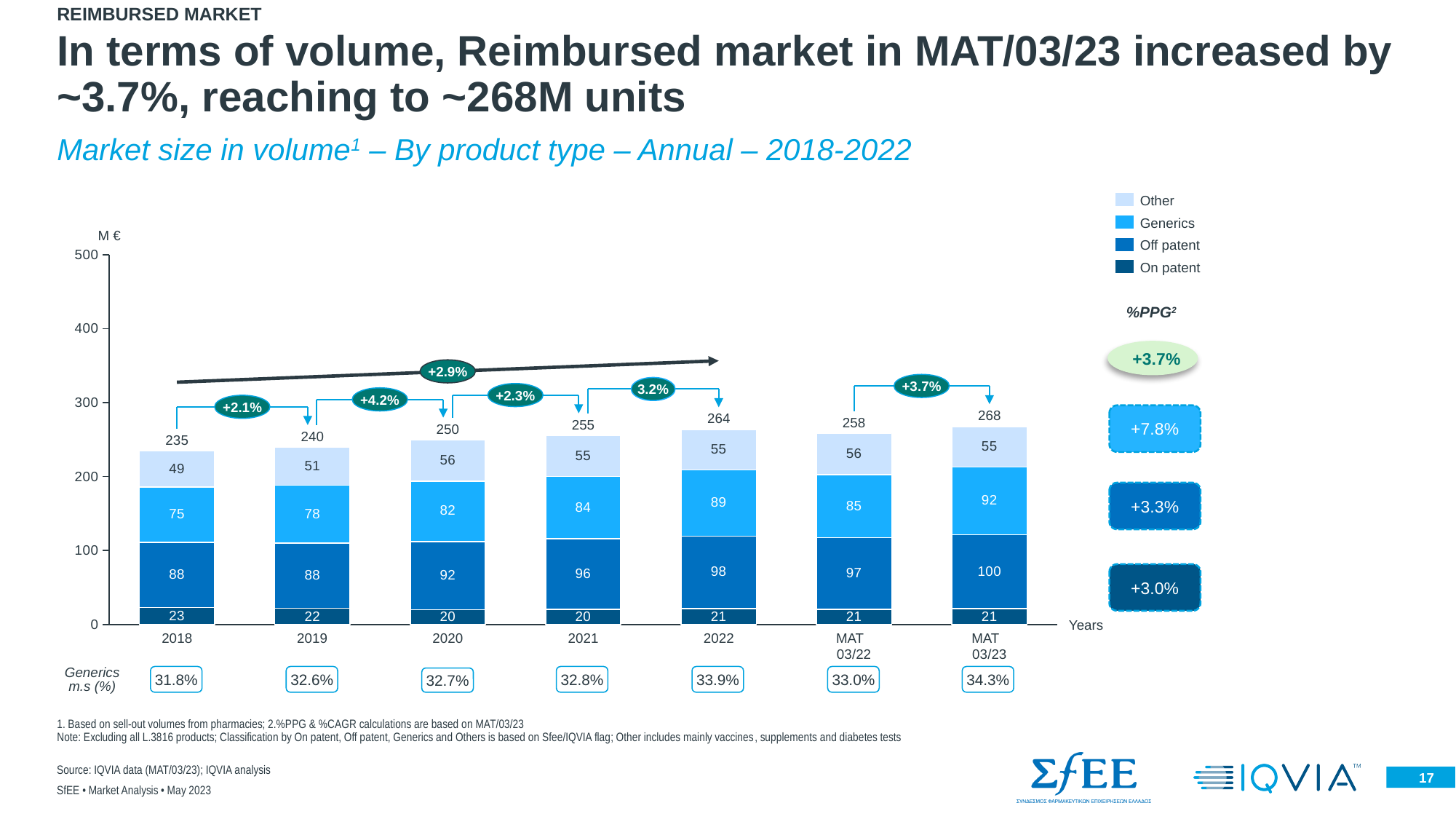
What kind of chart is shown on the slide? Stacked bar chart How many series does the legend list? 4 What is the total value of the 2021 bar? 255 In 2022, which is larger: the Generics value or the Off patent value? Off patent What is the Generics value for 2020? 82 What is the On patent value for 2018? 23 Which period has the highest total bar value? MAT 03/23 Which period has the lowest total bar value? 2018 What is the Off patent value for MAT 03/23? 100 What is the difference between the total for MAT 03/23 and the total for MAT 03/22? 10 Do the total bar values rise or fall from 2018 to 2022? Rise How many periods (bars) are shown on the x axis? 7